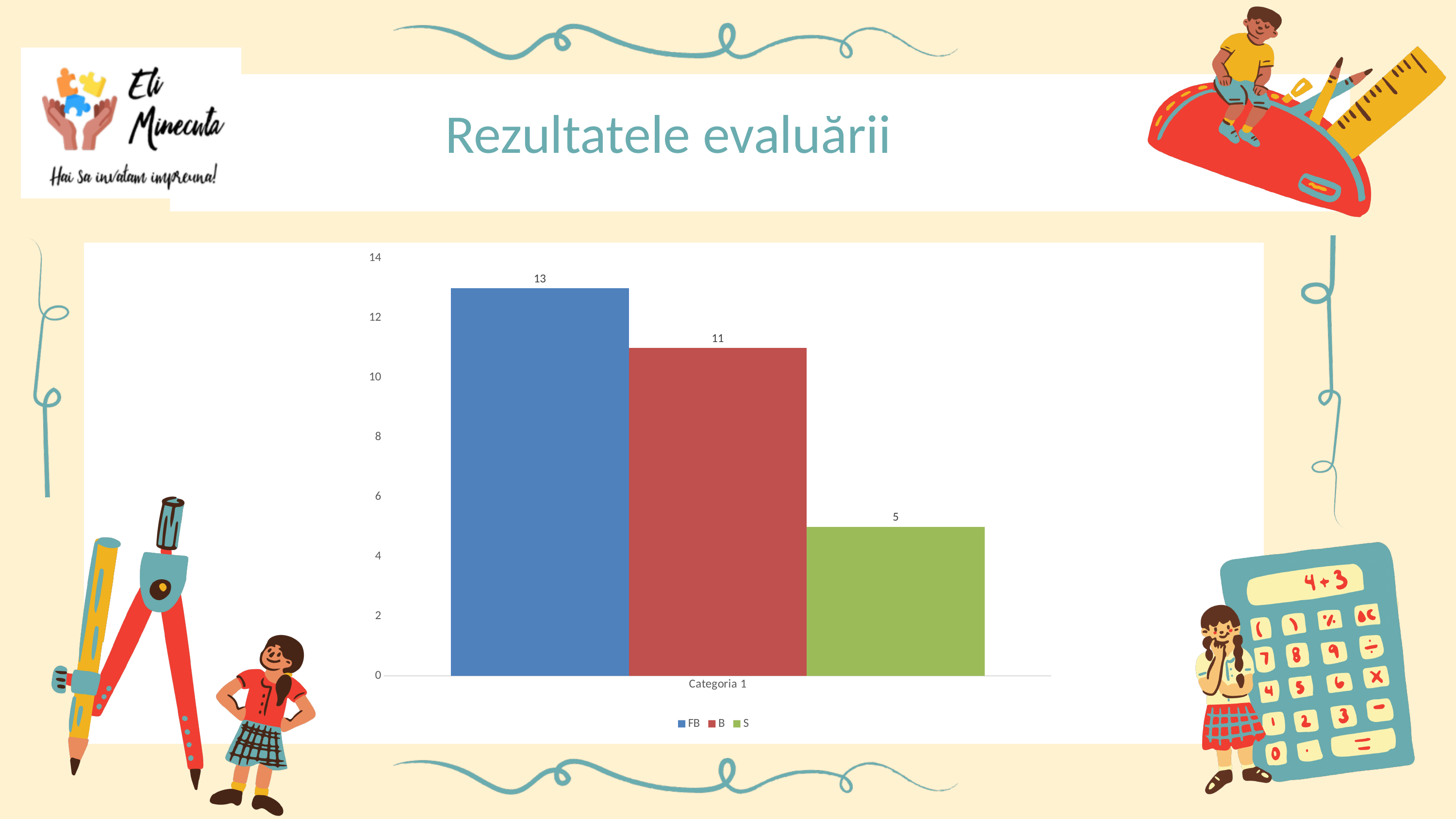
What kind of chart is shown on the slide? bar chart Is the value for S greater or less than 6? less What is the title of the slide containing the chart? Rezultatele evaluării What is the value for FB? 13 What is the difference between the values for FB and S? 8 Which is larger, the value for B or the value for S? B Which series has the lowest value? S Which series has the highest value? FB What is the value for S? 5 What is the difference between the values for FB and B? 2 How many series does the legend list? 3 What is the value for B? 11